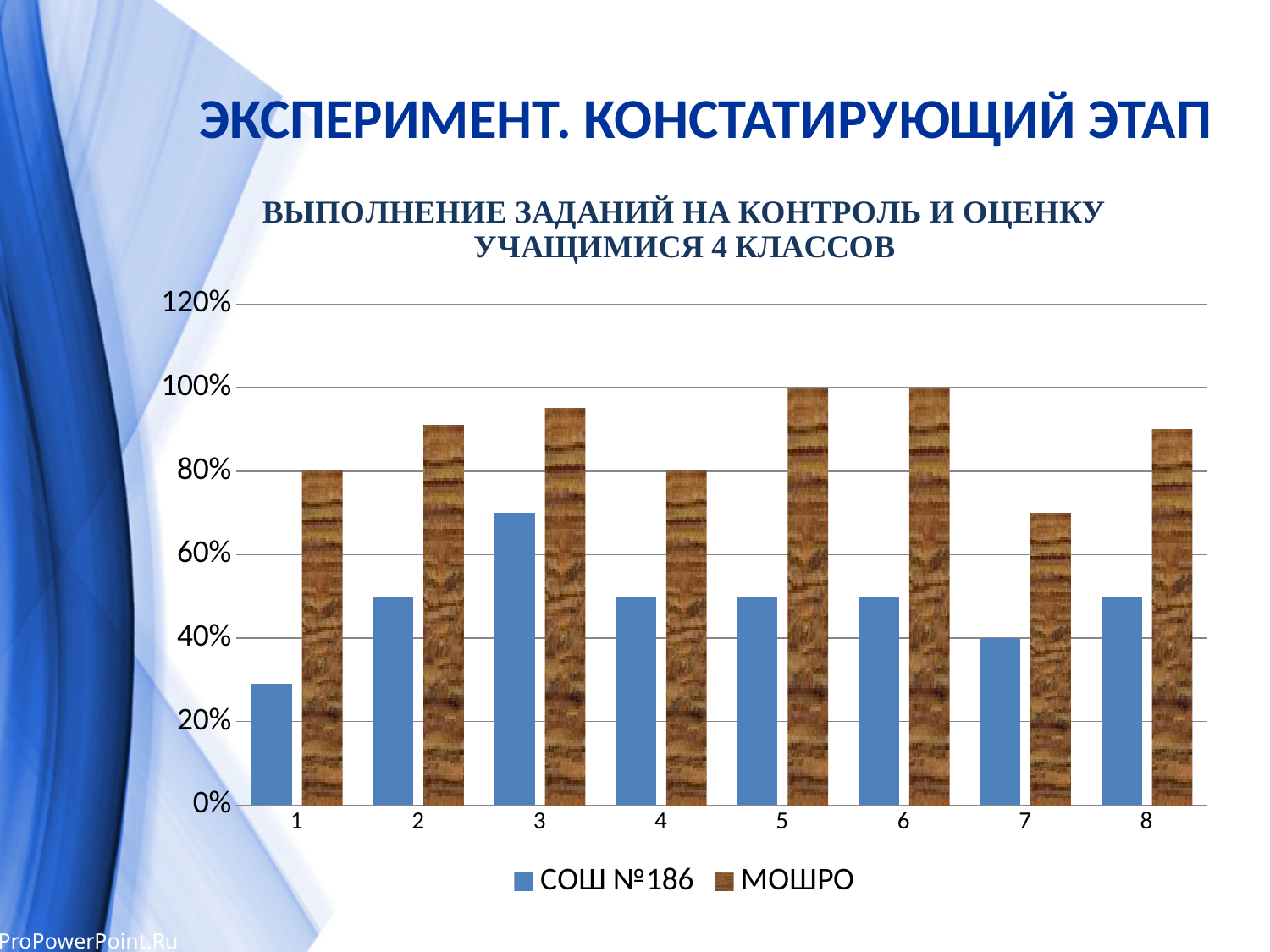
Is the value for МОШРО in category 3 greater or less than 80%? greater Is the value for СОШ №186 in category 1 greater or less than 40%? less What is the value for МОШРО in category 5? 100% How many categories are shown on the x axis? 8 What kind of chart is shown on the slide? bar chart How many series does the legend list? 2 What is the difference between the МОШРО values in category 5 and category 1? 20% In which category is the value for СОШ №186 the highest? 3 In which category is the value for СОШ №186 the lowest? 1 What is the value for СОШ №186 in category 7? 40% In which category is the value for МОШРО the lowest? 7 What is the value for МОШРО in category 1? 80%